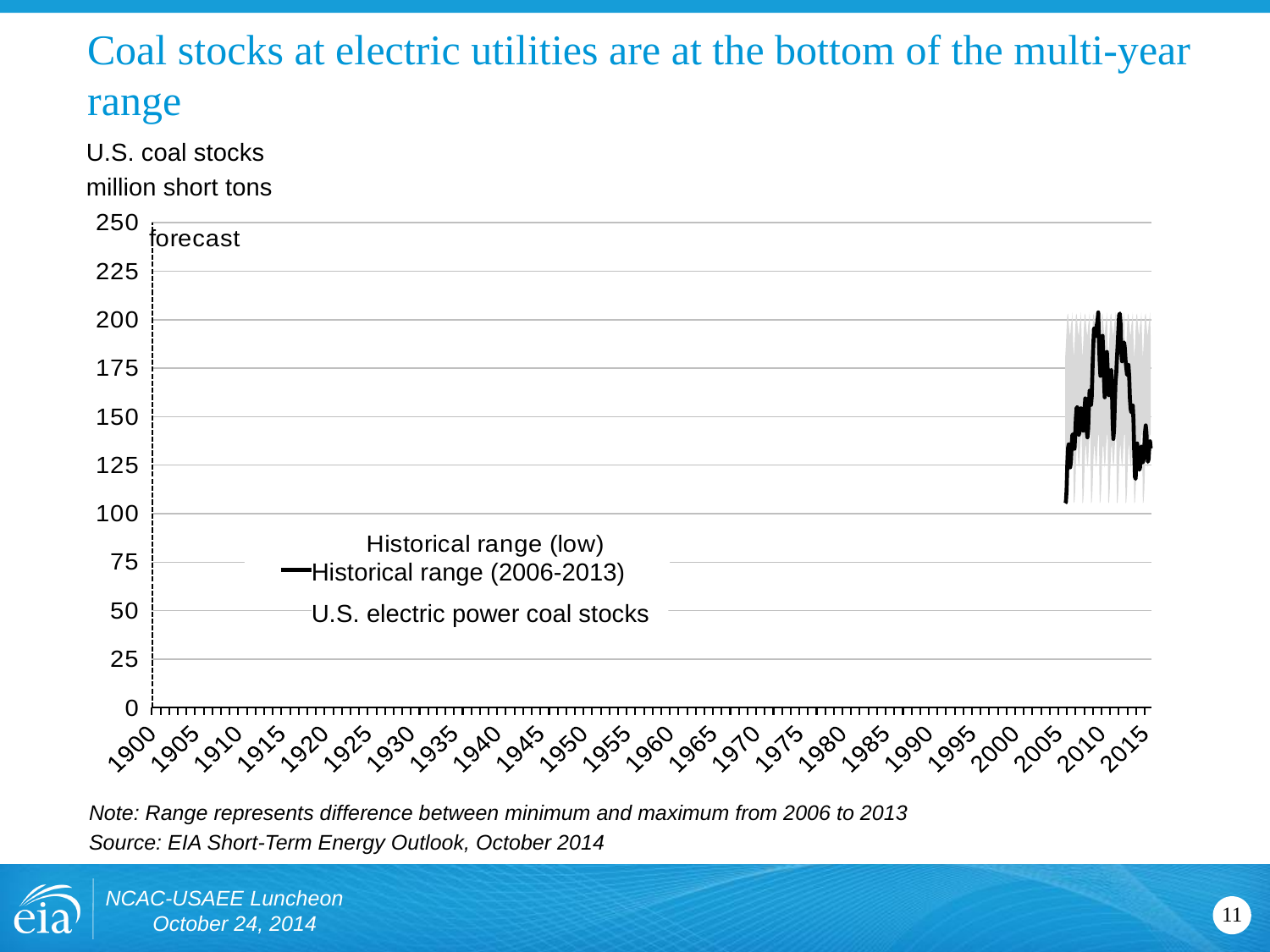
What is the title of the chart? U.S. coal stocks What is the last year label shown on the x axis? 2015 What is the first year label shown on the x axis? 1900 Is the lowest value of the U.S. electric power coal stocks line greater or less than 125? less Is the value of U.S. electric power coal stocks at the end of the forecast period greater or less than 150? less Is the peak value of the U.S. electric power coal stocks line greater or less than 175? greater Does the U.S. electric power coal stocks line rise or fall from its peak around 2008 to the end of the series? fall Does the U.S. electric power coal stocks line rise or fall from 2006 to its peak around 2008? rise How many series does the legend list? 3 What unit is used on the y axis of the chart? million short tons What is the highest value shown on the y axis? 250 What kind of chart is shown on the slide? line chart